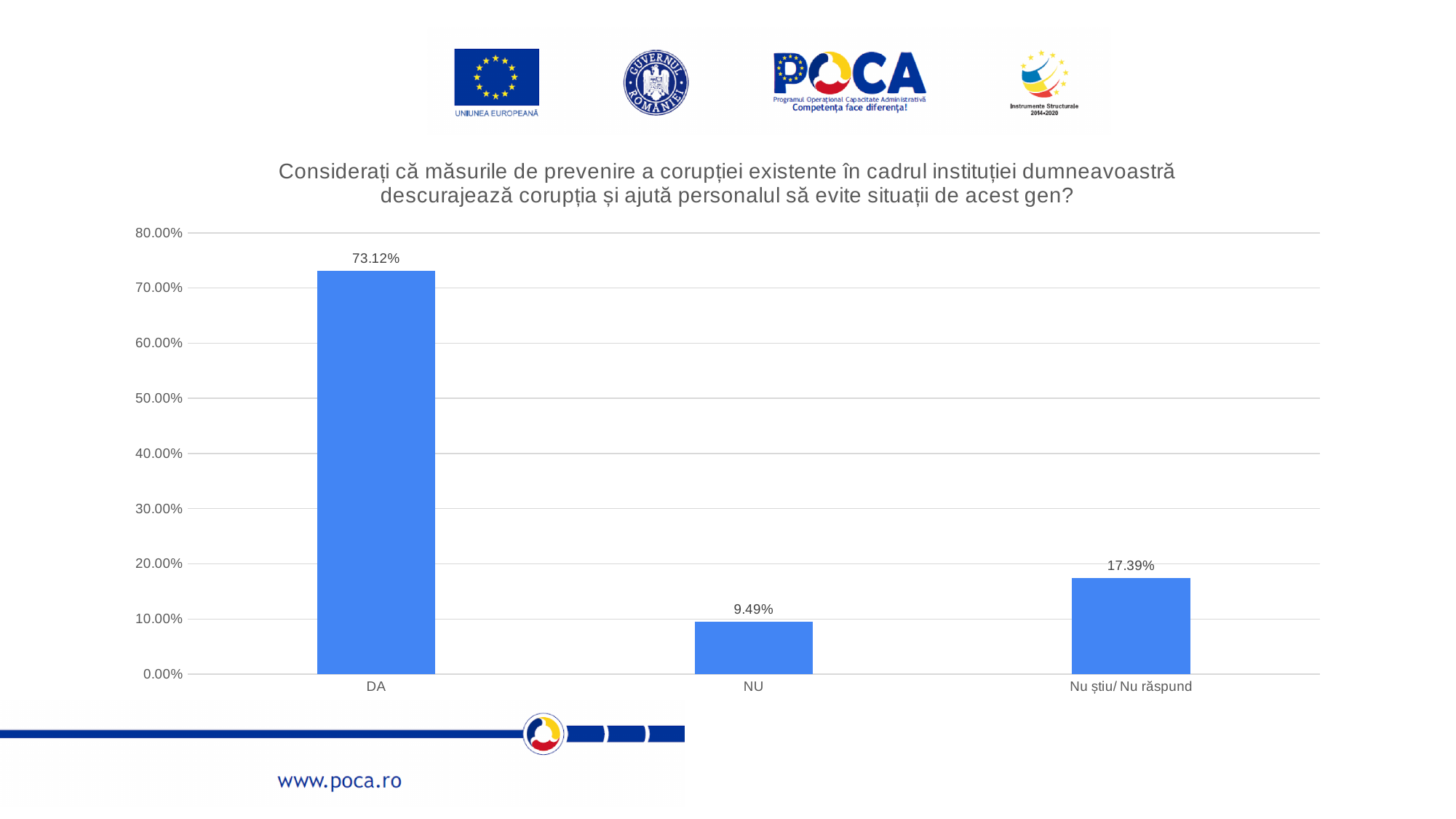
What is the difference between the values for DA and NU? 63.63% Is the value for DA greater or less than 70.00%? greater What is the value for DA? 73.12% Which is larger, the value for NU or the value for Nu știu/ Nu răspund? Nu știu/ Nu răspund What is the value for NU? 9.49% What is the difference between the values for Nu știu/ Nu răspund and NU? 7.90% What is the value for Nu știu/ Nu răspund? 17.39% How many categories are shown on the x axis? 3 What is the highest value shown on the y axis? 80.00% Which category has the highest value? DA What kind of chart is shown on the slide? bar chart Which category has the lowest value? NU